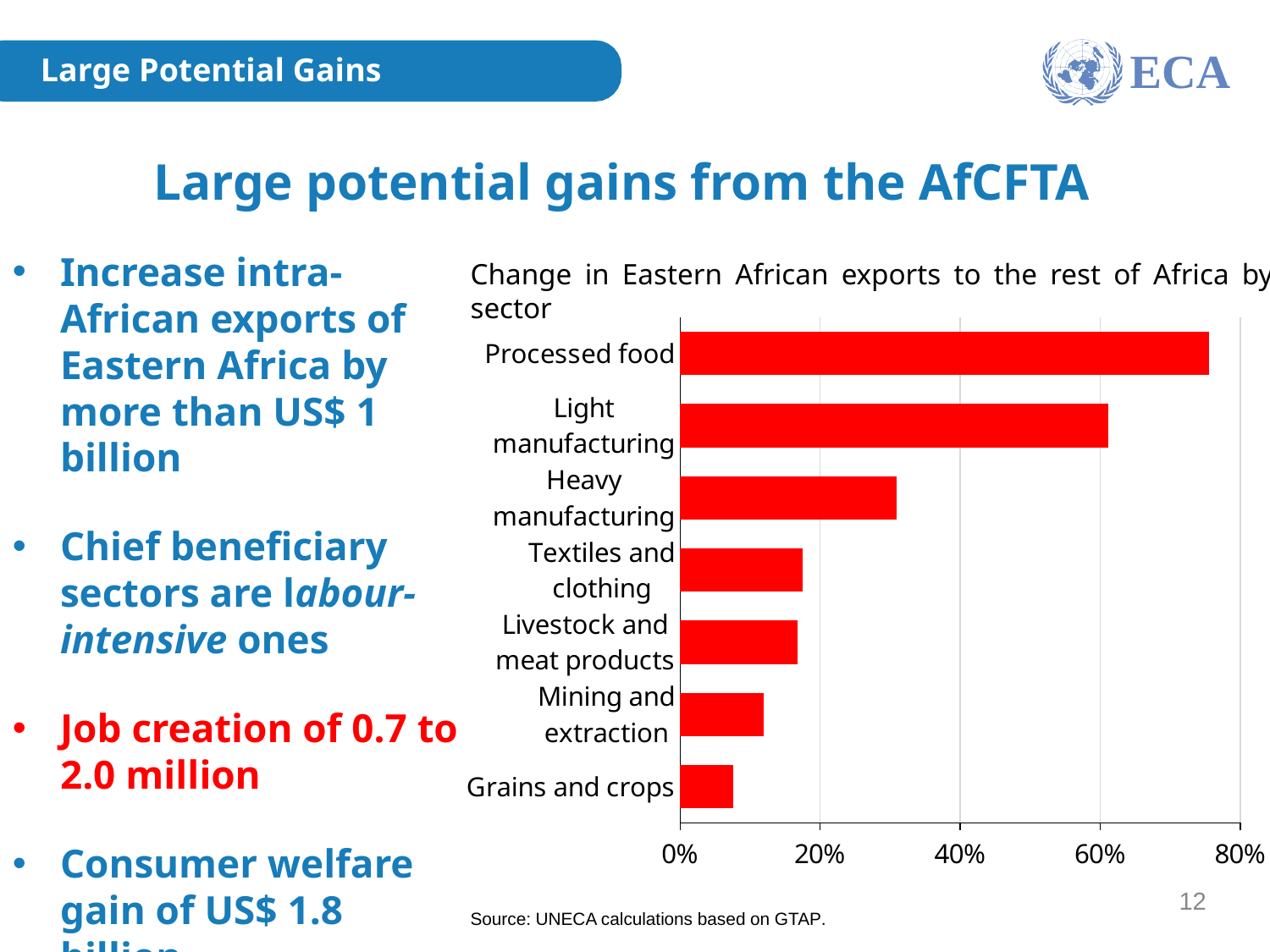
What is the title of the chart? Change in Eastern African exports to the rest of Africa by sector Which is larger, the value for Heavy manufacturing or the value for Textiles and clothing? Heavy manufacturing Is the value for Light manufacturing greater or less than 80%? less Is the value for Heavy manufacturing greater or less than 40%? less Which sector shows the largest change in Eastern African exports to the rest of Africa? Processed food Which sector shows the smallest change in Eastern African exports to the rest of Africa? Grains and crops What is the source cited below the chart? UNECA calculations based on GTAP. What kind of chart is shown on the slide? Bar chart Which is larger, the value for Processed food or the value for Light manufacturing? Processed food Is the value for Processed food greater or less than 60%? greater How many sectors are plotted in the chart? 7